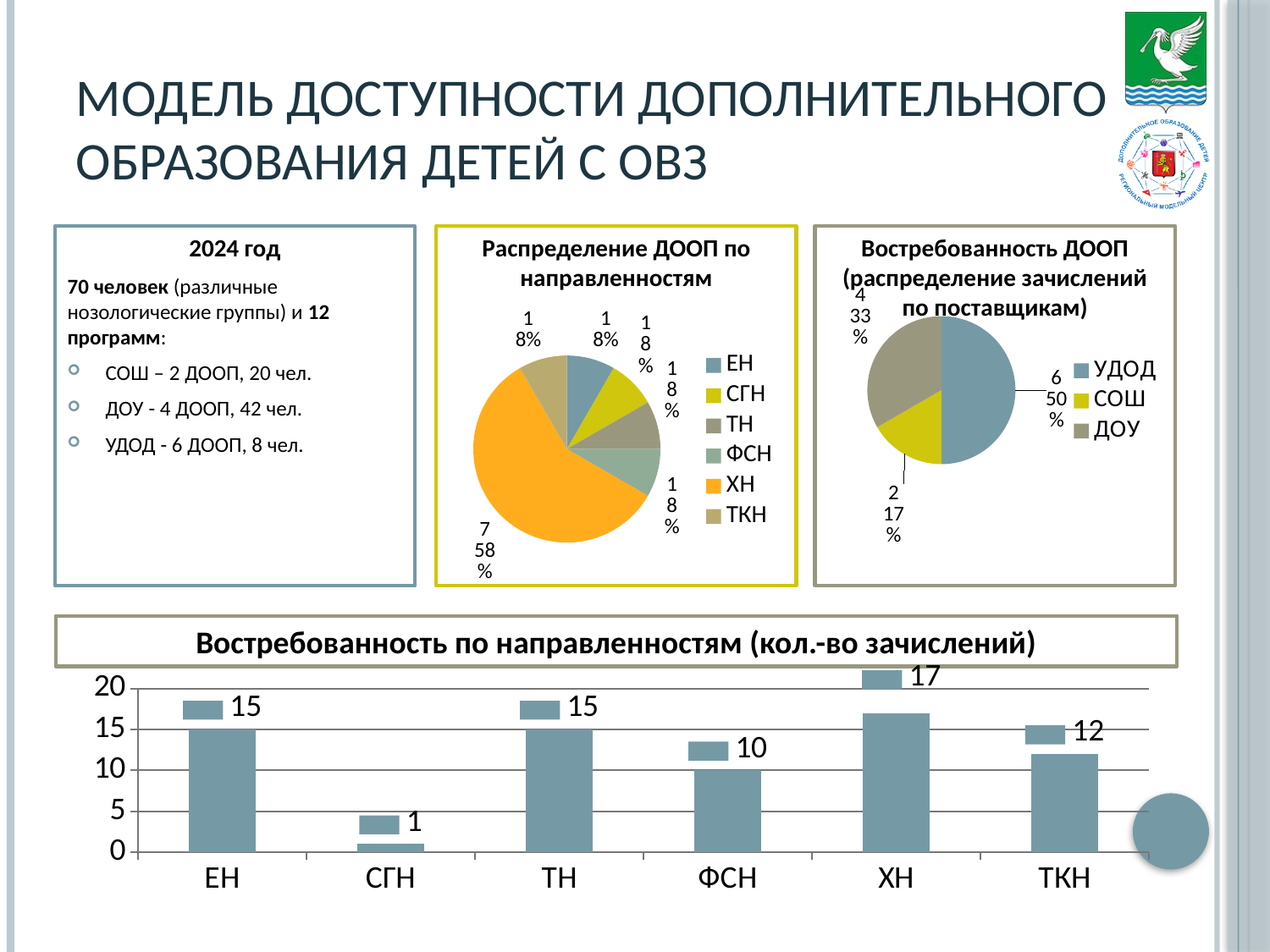
In the bar chart 'Востребованность по направленностям (кол.-во зачислений)', what is the value for ФСН? 10 In the bar chart 'Востребованность по направленностям (кол.-во зачислений)', which category has the highest value? ХН In the pie chart 'Распределение ДООП по направленностям', what share does ХН have? 58% How many entries does the legend of the pie chart 'Распределение ДООП по направленностям' list? 6 In the bar chart 'Востребованность по направленностям (кол.-во зачислений)', which is larger, the value for ФСН or the value for ТКН? ТКН In the bar chart 'Востребованность по направленностям (кол.-во зачислений)', which category has the lowest value? СГН In the bar chart 'Востребованность по направленностям (кол.-во зачислений)', what is the value for ХН? 17 In the bar chart 'Востребованность по направленностям (кол.-во зачислений)', what is the difference between the values for ХН and ТКН? 5 In the pie chart 'Востребованность ДООП (распределение зачислений по поставщикам)', what share does УДОД have? 50% What kind of chart is 'Востребованность по направленностям (кол.-во зачислений)'? bar chart How many categories are shown in the bar chart 'Востребованность по направленностям (кол.-во зачислений)'? 6 In the pie chart 'Востребованность ДООП (распределение зачислений по поставщикам)', what is the value for СОШ? 2